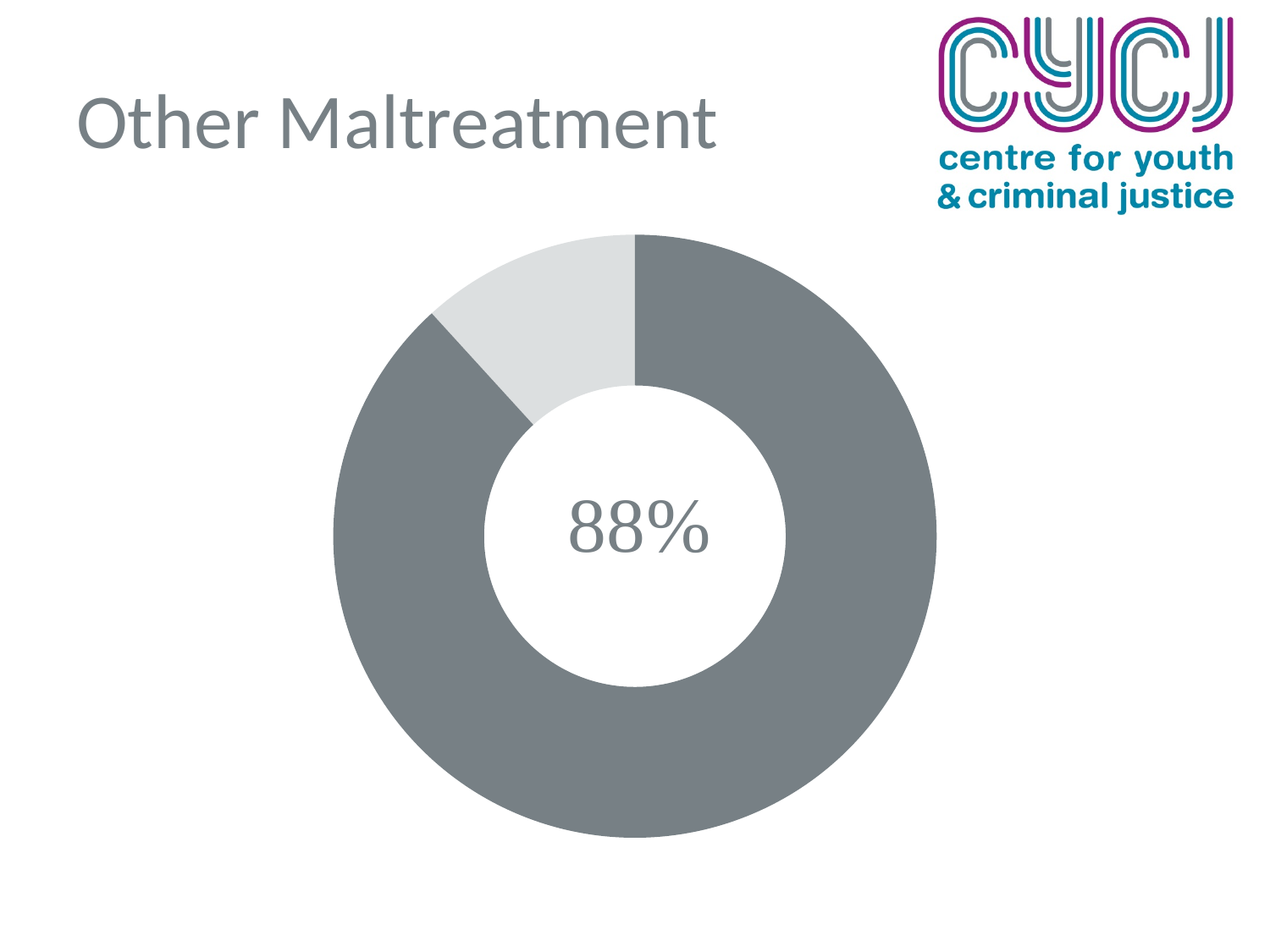
How many slices does the doughnut chart have? 2 Which slice of the doughnut chart is larger, the dark grey one or the light grey one? The dark grey one What share of the doughnut chart does the dark grey slice represent? 88% Is the share of the dark grey slice greater or less than 50%? greater What is the title of the slide containing the doughnut chart? Other Maltreatment Does the doughnut chart have a legend? No Is the share of the light grey slice greater or less than 25%? less What percentage is printed in the centre of the doughnut chart? 88% What kind of chart is shown on the slide? Doughnut (pie) chart